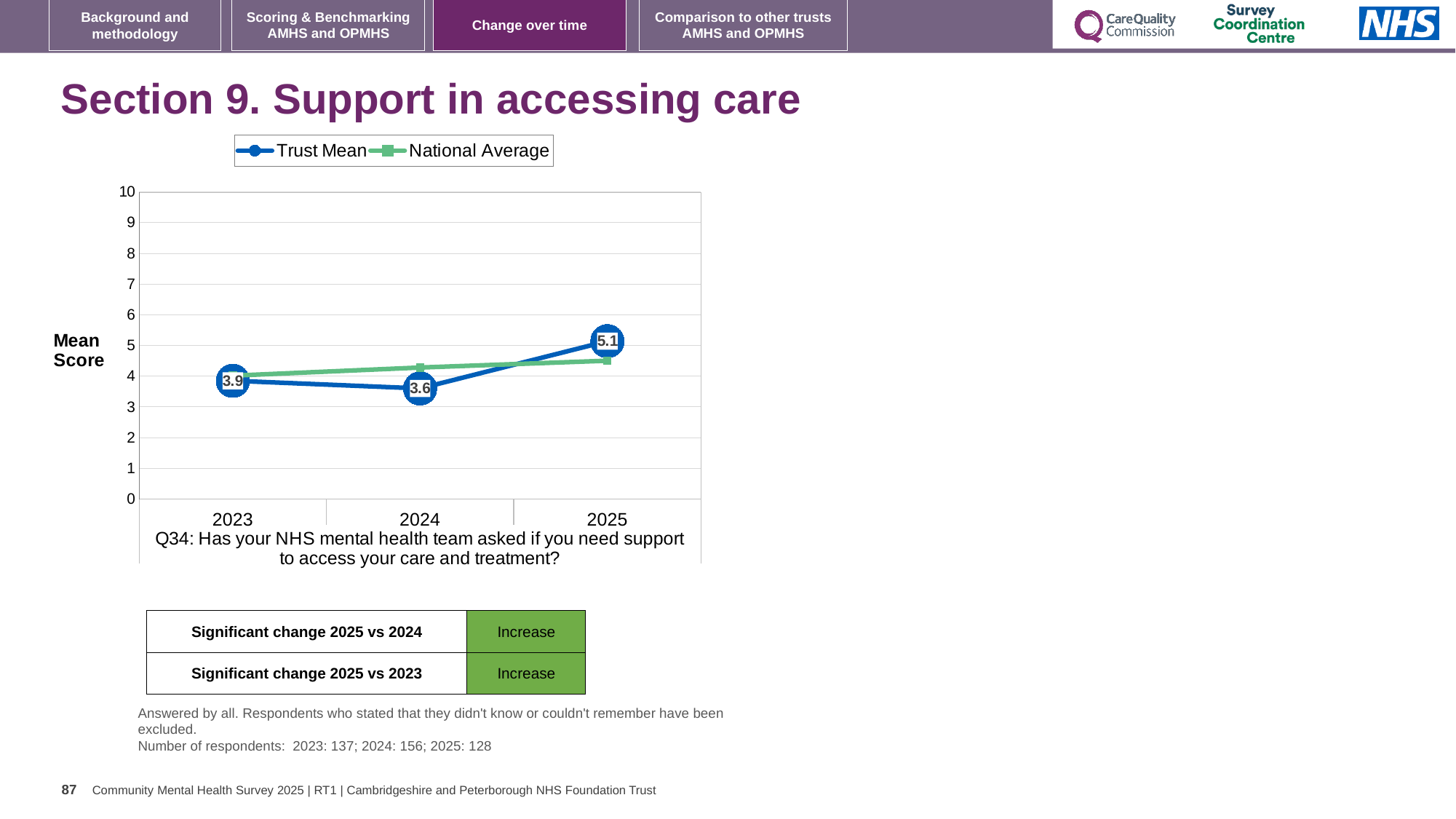
What is the Trust Mean score for 2023? 3.9 Which is larger, the Trust Mean in 2023 or in 2024? 2023 Is the National Average for 2025 greater or less than 5? less How many years are shown on the x axis? 3 What is the difference between the Trust Mean in 2025 and in 2024? 1.5 In which year is the Trust Mean highest? 2025 In which year is the Trust Mean lowest? 2024 Does the Trust Mean rise or fall from 2024 to 2025? rise What kind of chart is shown on the slide? line chart How many series does the legend list? 2 What is the Trust Mean score for 2025? 5.1 What is the Trust Mean score for 2024? 3.6